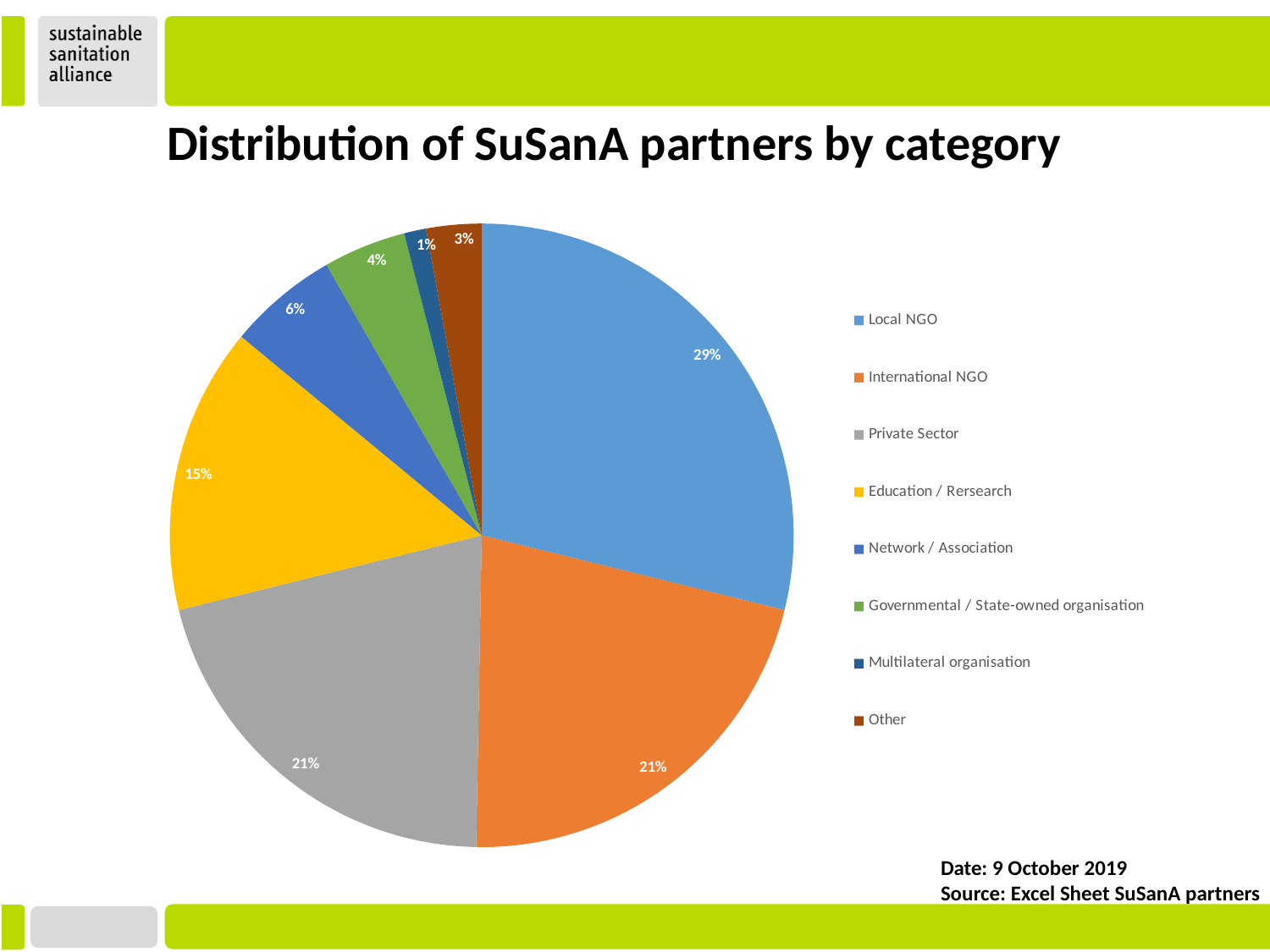
Which is larger, the share for Network / Association or the share for Other? Network / Association What share of SuSanA partners are Local NGOs? 29% What share of SuSanA partners are in the Education / Rersearch category? 15% What share of SuSanA partners are Network / Association? 6% Which category has the largest share of SuSanA partners? Local NGO What kind of chart is shown on the slide? pie chart Which category has the smallest share of SuSanA partners? Multilateral organisation What is the difference in percentage points between the Local NGO share and the Education / Rersearch share? 14 How many categories does the legend list? 8